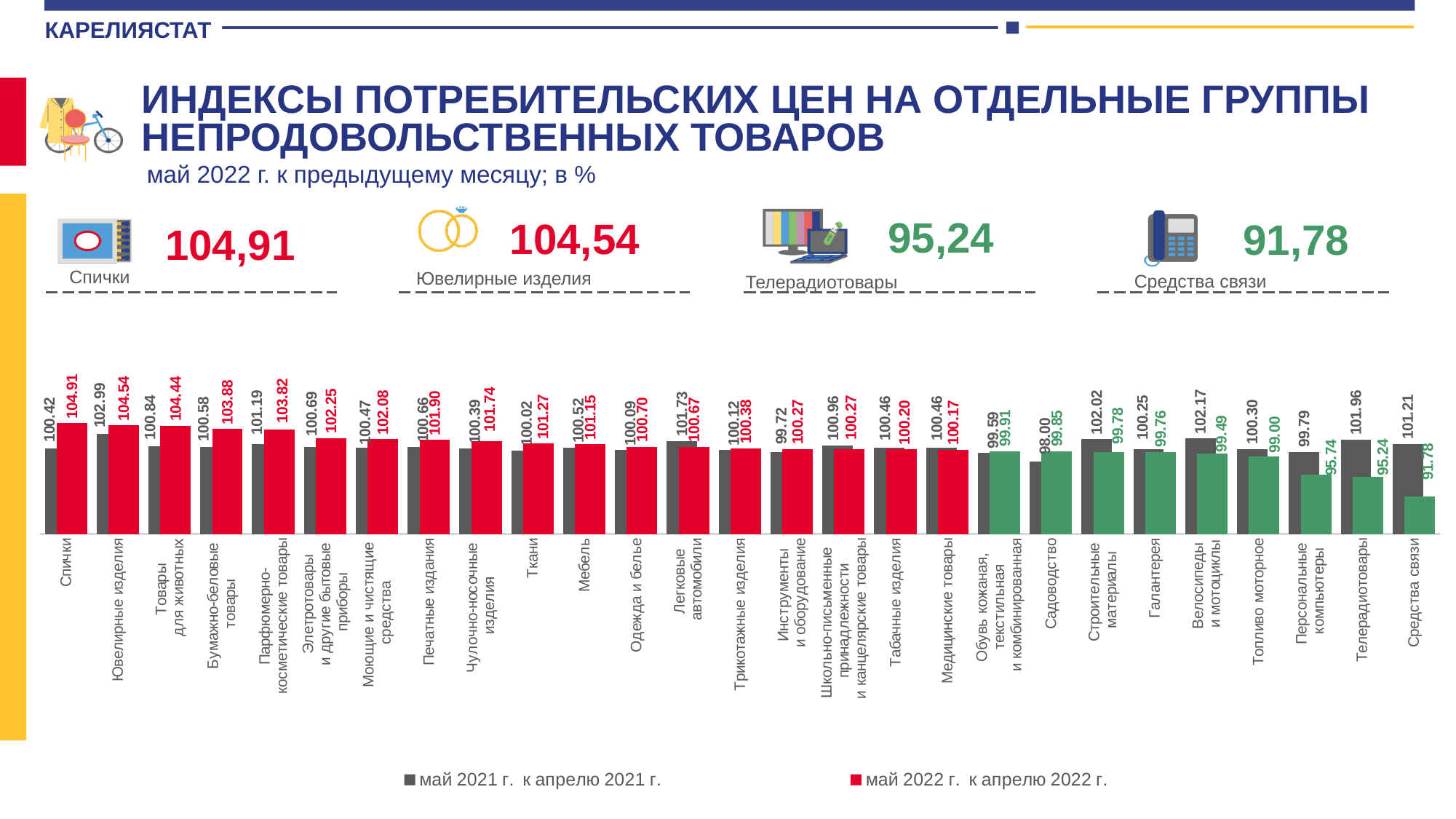
How many series does the chart legend list? 2 What is the value for Спички in the series 'май 2022 г. к апрелю 2022 г.'? 104,91 What is the value for Ювелирные изделия in the series 'май 2021 г. к апрелю 2021 г.'? 102.99 Do the values of the series 'май 2022 г. к апрелю 2022 г.' rise or fall from left to right along the x axis? fall How many product groups (categories) are shown on the x axis of the chart? 27 Which category has the lowest value in the series 'май 2021 г. к апрелю 2021 г.'? Садоводство Which category has the lowest value in the series 'май 2022 г. к апрелю 2022 г.'? Средства связи What type of chart is shown on the slide? bar chart For Телерадиотовары, which series has the larger value: 'май 2021 г. к апрелю 2021 г.' or 'май 2022 г. к апрелю 2022 г.'? май 2021 г. к апрелю 2021 г. What is the difference between the 'май 2022 г. к апрелю 2022 г.' and 'май 2021 г. к апрелю 2021 г.' values for Спички? 4,49 Which category has the highest value in the series 'май 2022 г. к апрелю 2022 г.'? Спички What is the value for Средства связи in the series 'май 2022 г. к апрелю 2022 г.'? 91,78